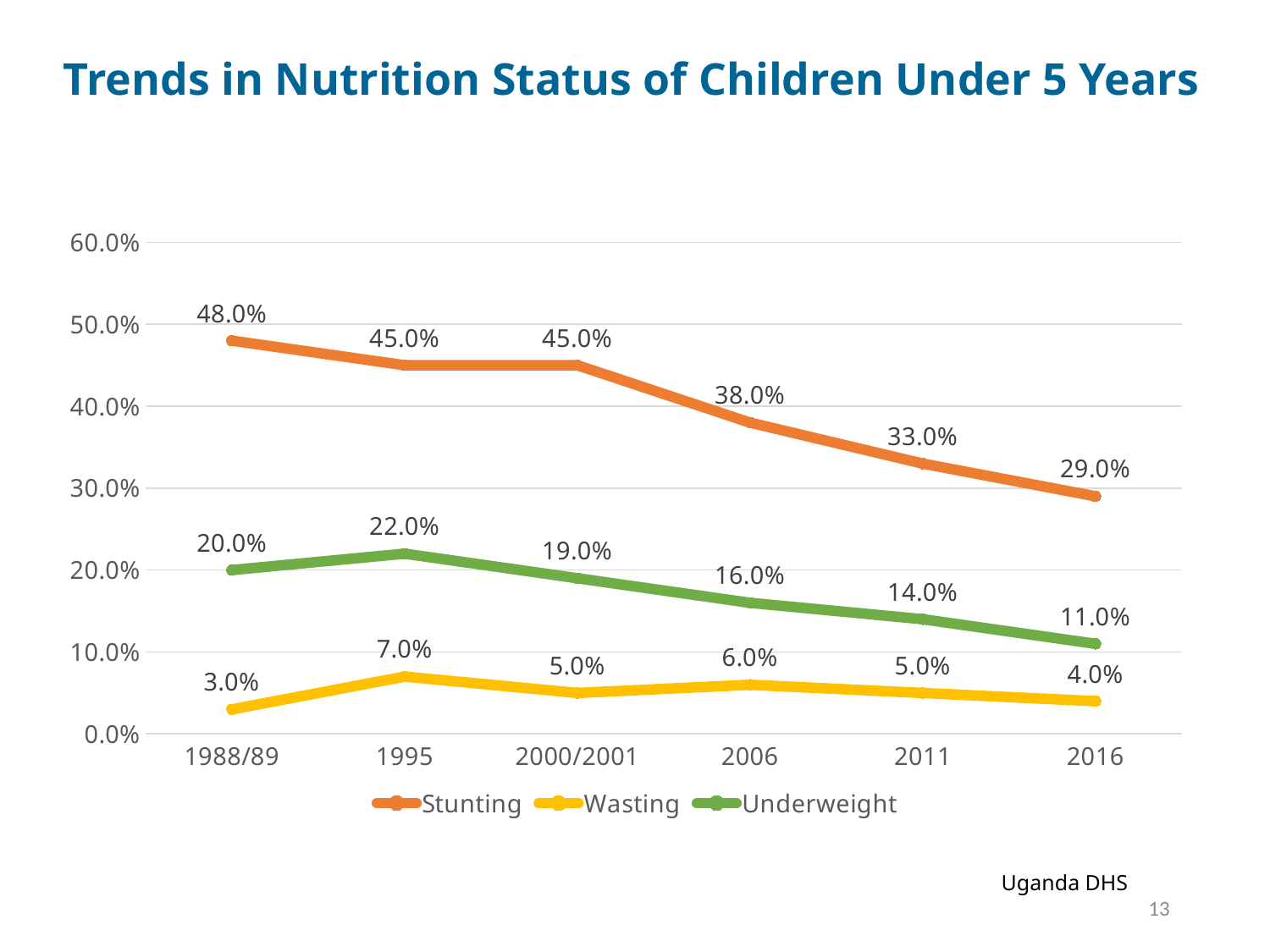
What colour is the line for the Wasting series? Yellow What kind of chart is shown on the slide? Line chart Which is larger in 2011: the underweight value or the wasting value? Underweight How many time points are shown on the x axis? 6 What is the wasting value for 1995? 7.0% In which year is the wasting value lowest? 1988/89 What is the stunting value for 2016? 29.0% What is the difference between the stunting value in 1988/89 and in 2016? 19.0% Does the stunting series rise or fall from 1988/89 to 2016? Fall In which year is the stunting value highest? 1988/89 What is the underweight value for 2006? 16.0% How many series does the legend list? 3